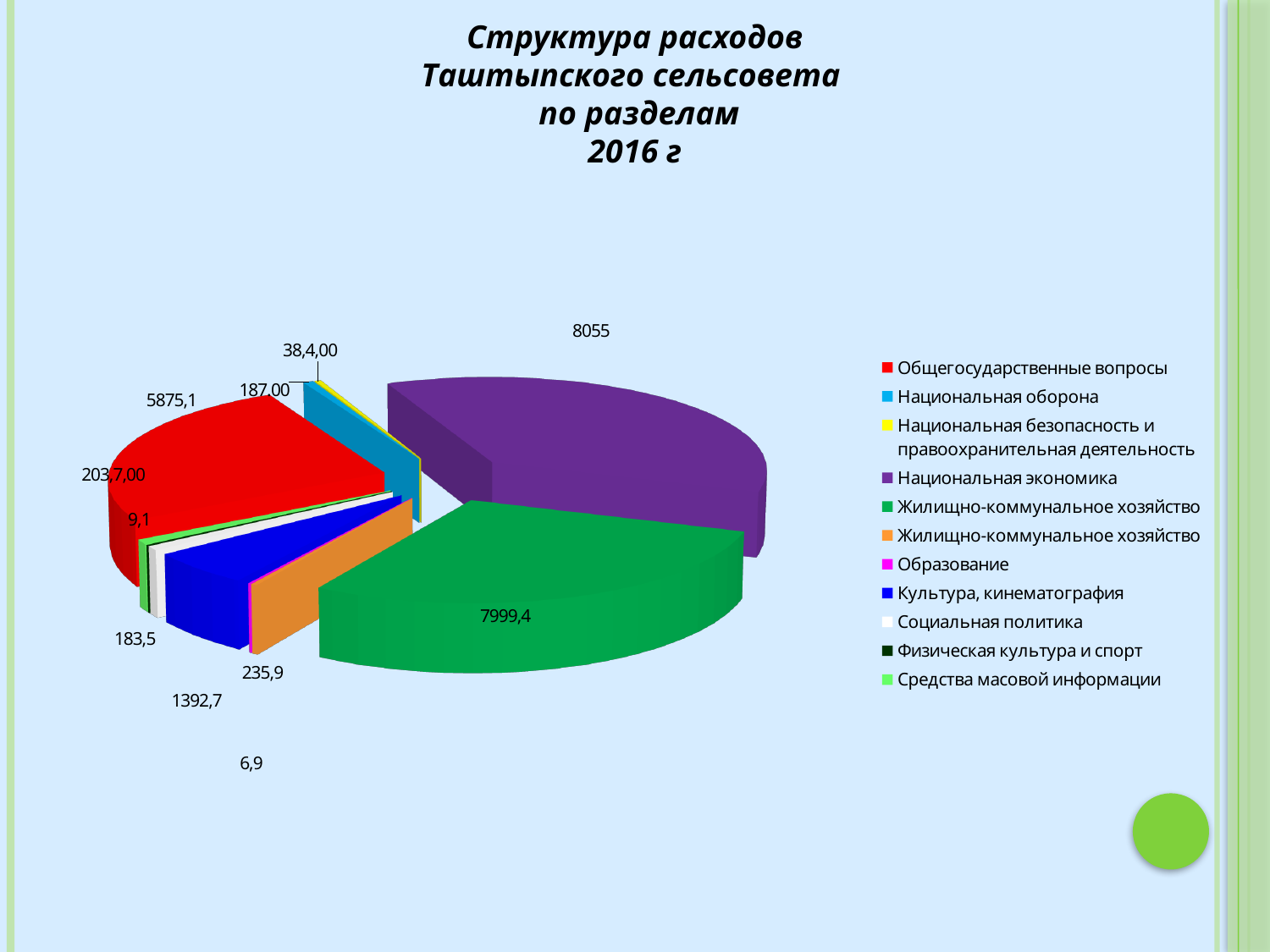
What colour is the Национальная экономика slice? purple What is the difference between the Национальная экономика value and the green Жилищно-коммунальное хозяйство value? 55,6 What is the title of the chart? Структура расходов Таштыпского сельсовета по разделам 2016 г Which is larger: Общегосударственные вопросы or the green Жилищно-коммунальное хозяйство slice? Жилищно-коммунальное хозяйство (green) What is the value for Культура, кинематография? 1392,7 What is the value for Общегосударственные вопросы? 5875,1 What type of chart is shown on the slide? pie chart What is the value shown on the green Жилищно-коммунальное хозяйство slice? 7999,4 What is the value for Национальная экономика? 8055 Which category has the largest slice of the pie? Национальная экономика What is the difference between the green Жилищно-коммунальное хозяйство value and the Общегосударственные вопросы value? 2124,3 How many categories does the legend list? 11